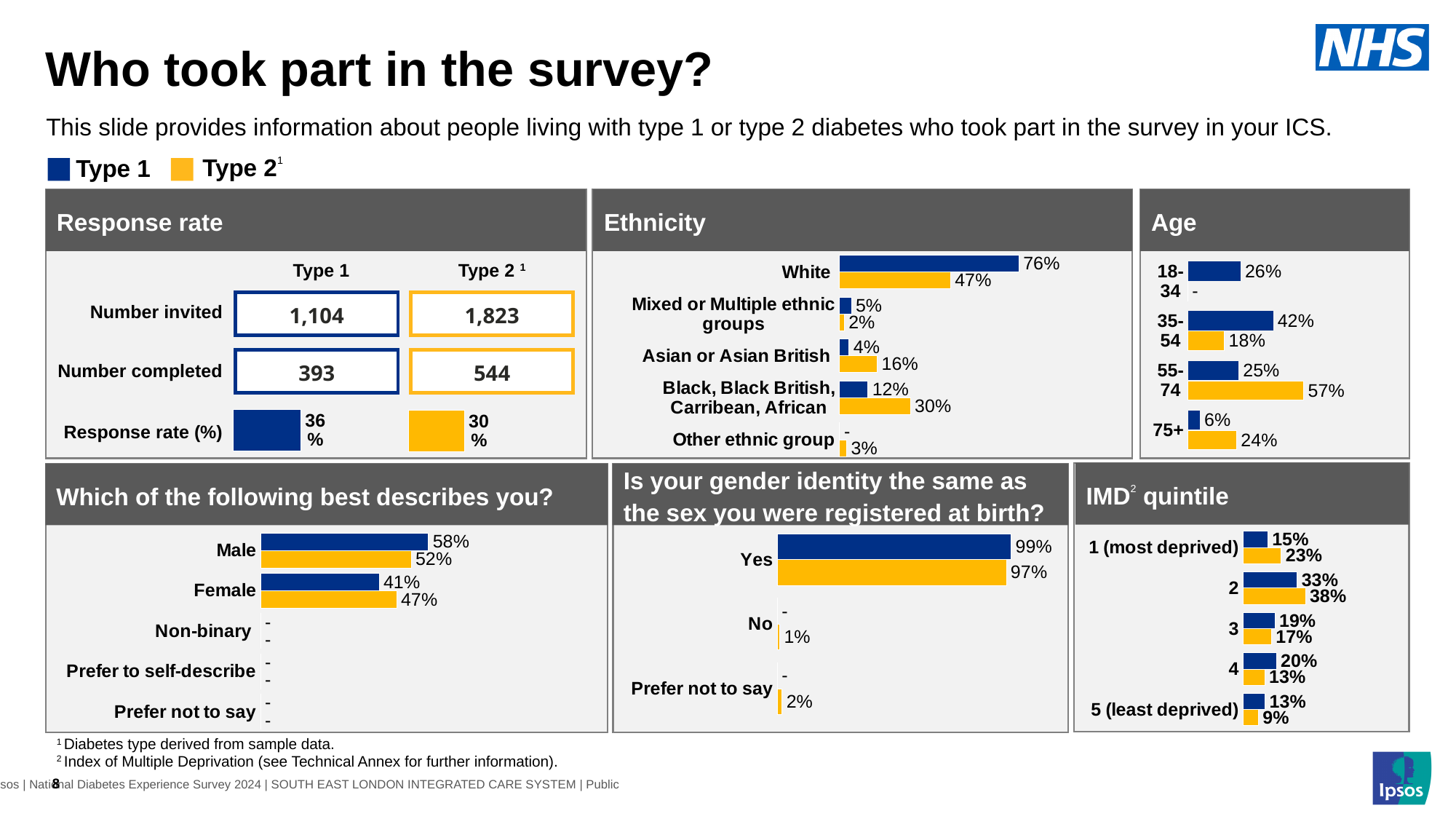
In the Ethnicity chart, what is the Type 2 value for Asian or Asian British? 16% In the Ethnicity chart, what is the Type 1 value for White? 76% What type of chart is the Age chart? Bar chart In the gender identity chart, what is the Type 2 value for Yes? 97% In the Age chart, what is the difference between the Type 2 and Type 1 values for 75+? 18% How many ethnic group categories are shown in the Ethnicity chart? 5 In the IMD quintile chart, which quintile has the lowest Type 2 value? 5 (least deprived) In the 'Which of the following best describes you?' chart, which is larger for Male: Type 1 or Type 2? Type 1 In the IMD quintile chart, what is the difference between the Type 2 and Type 1 values for quintile 1 (most deprived)? 8% In the Age chart, which age group has the highest Type 2 value? 55-74 In the Response rate chart, what is the number completed for Type 2? 544 In the 'Which of the following best describes you?' chart, what is the Type 1 value for Female? 41%